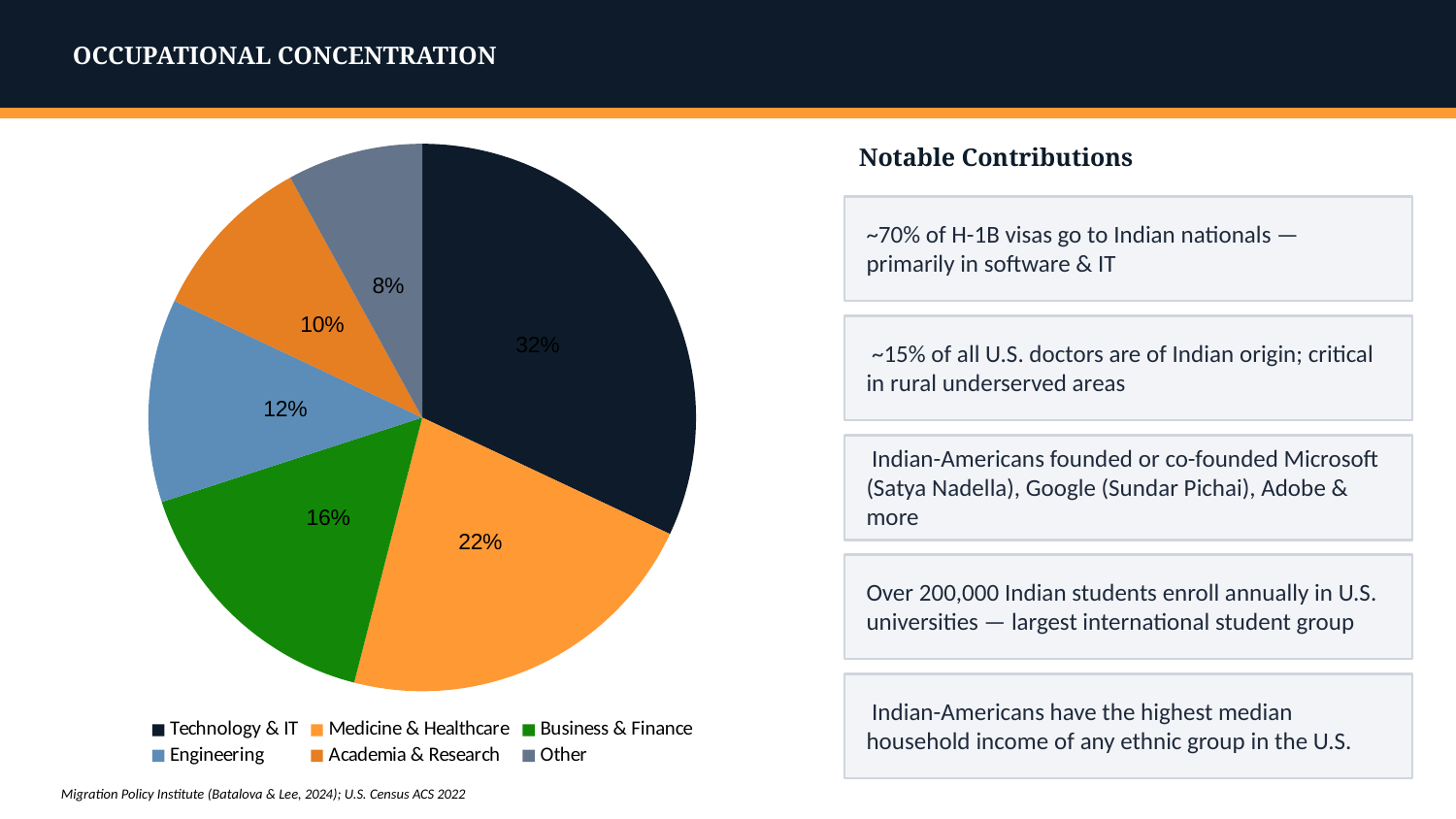
What is the value shown for Academia & Research? 10% What share of the pie does Technology & IT hold? 32% Which category has the largest slice of the pie? Technology & IT Which category has the smallest slice of the pie? Other What colour is the Business & Finance slice? Green What type of chart is shown on the slide? Pie chart How many entries does the legend list? 6 What is the value shown for Engineering? 12% Which is larger, Business & Finance or Engineering? Business & Finance What is the value shown for Medicine & Healthcare? 22% What is the difference in percentage points between Technology & IT and Medicine & Healthcare? 10 How many slices does the pie chart have? 6